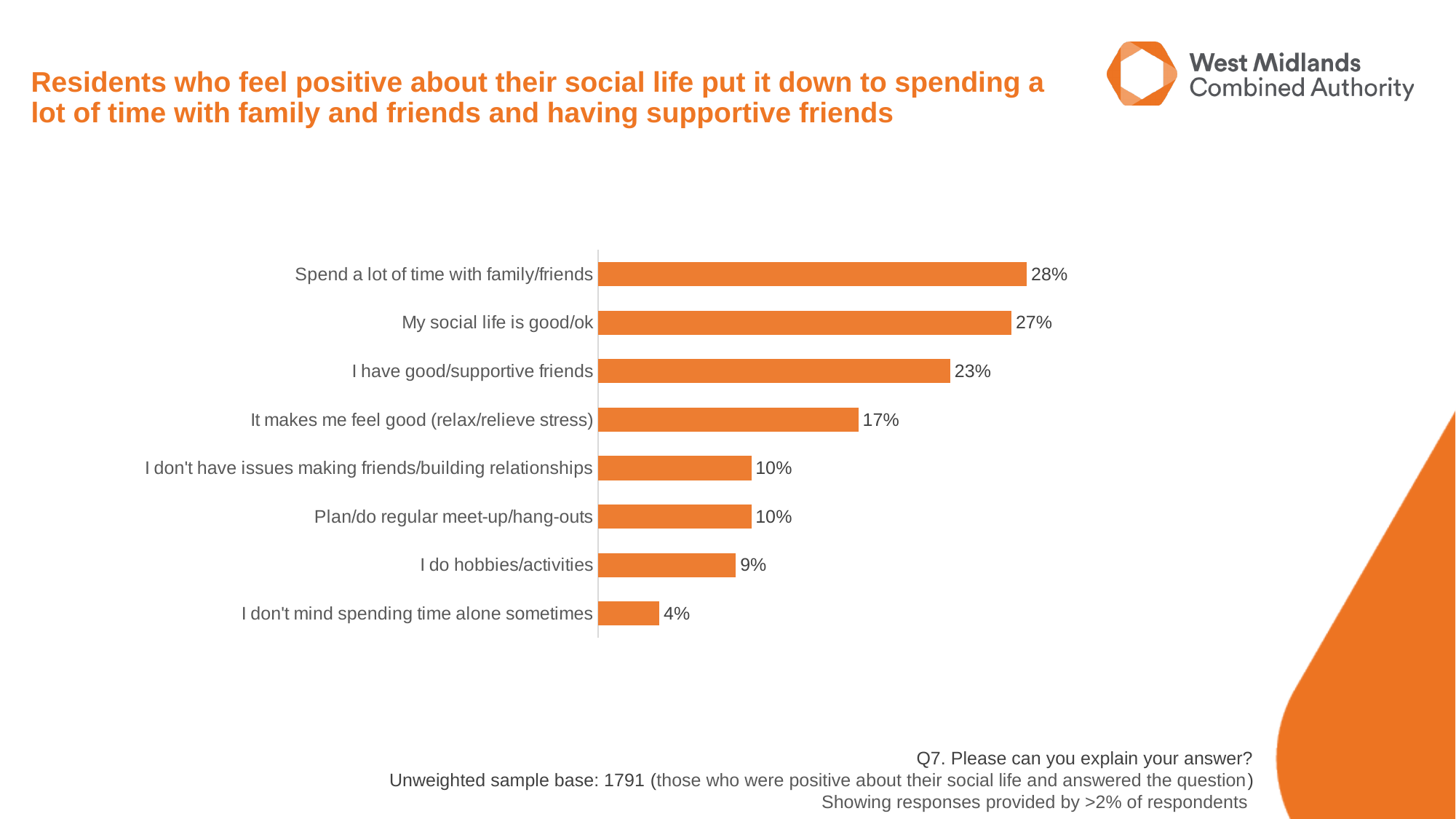
What is the difference between 'Spend a lot of time with family/friends' and 'I have good/supportive friends'? 5% What kind of chart is shown on the slide? Bar chart How many categories are shown in the chart? 8 What is the unweighted sample base stated on the slide? 1791 What is the difference between 'My social life is good/ok' and 'I don't mind spending time alone sometimes'? 23% Which category has the lowest value? I don't mind spending time alone sometimes What is the value for 'I do hobbies/activities'? 9% Which category has the highest value? Spend a lot of time with family/friends What percentage of respondents said 'It makes me feel good (relax/relieve stress)'? 17% Which is larger: 'It makes me feel good (relax/relieve stress)' or 'Plan/do regular meet-up/hang-outs'? It makes me feel good (relax/relieve stress) What is the value for 'I have good/supportive friends'? 23% What percentage of respondents said they spend a lot of time with family/friends? 28%